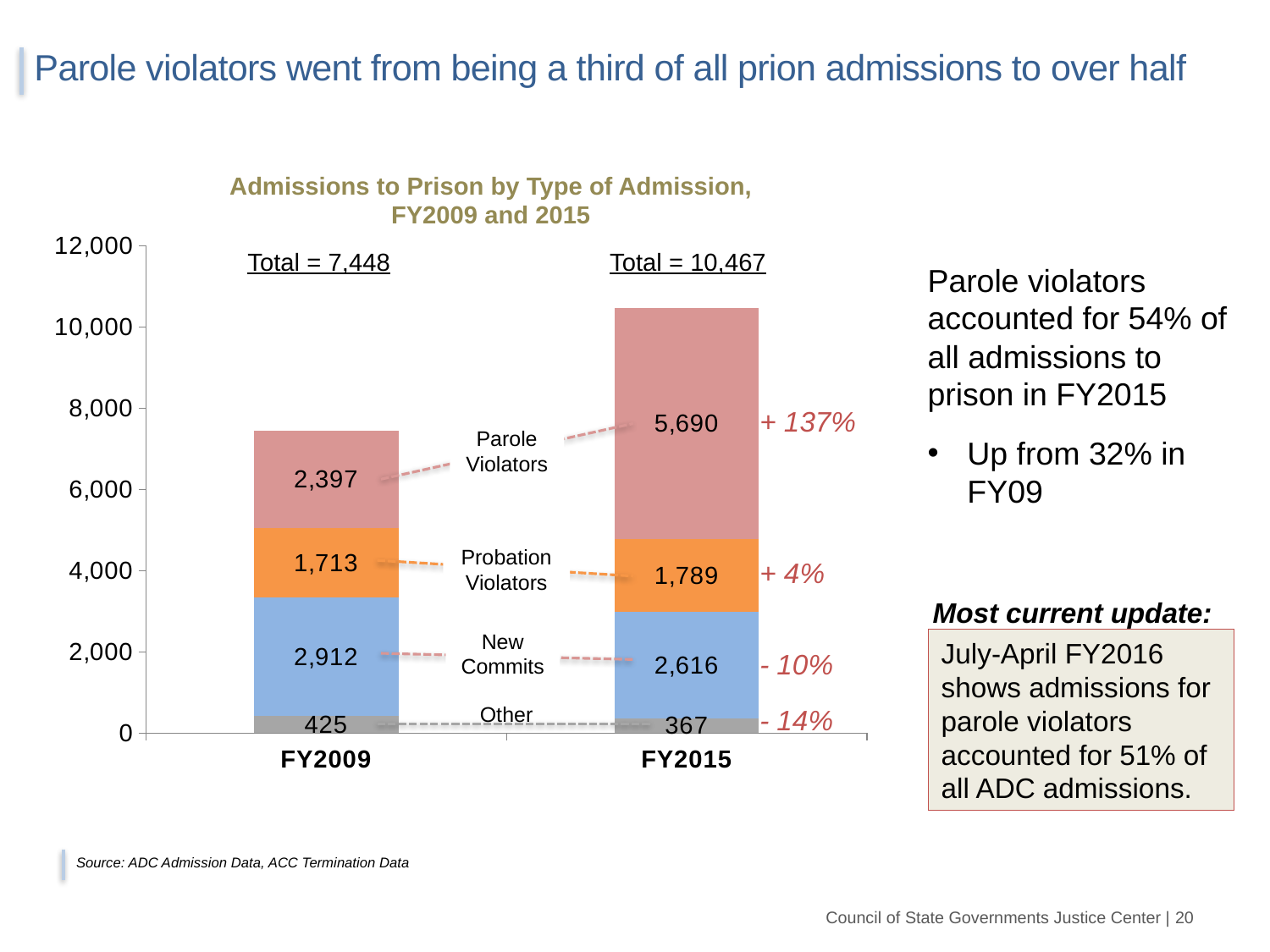
Which segment is the largest in the FY2009 bar? New Commits What is the value for Probation Violators in FY2009? 1,713 What is the title of the chart? Admissions to Prison by Type of Admission, FY2009 and 2015 What kind of chart is shown on the slide? Stacked bar chart What is the value for Other in FY2015? 367 What is the value for Parole Violators in FY2015? 5,690 What is the total of the FY2009 stacked bar? 7,448 What is the total of the FY2015 stacked bar? 10,467 What is the difference between Parole Violators in FY2015 and FY2009? 3,293 Which segment is the smallest in the FY2015 bar? Other What is the value for New Commits in FY2009? 2,912 Is the value for New Commits larger in FY2009 or FY2015? FY2009